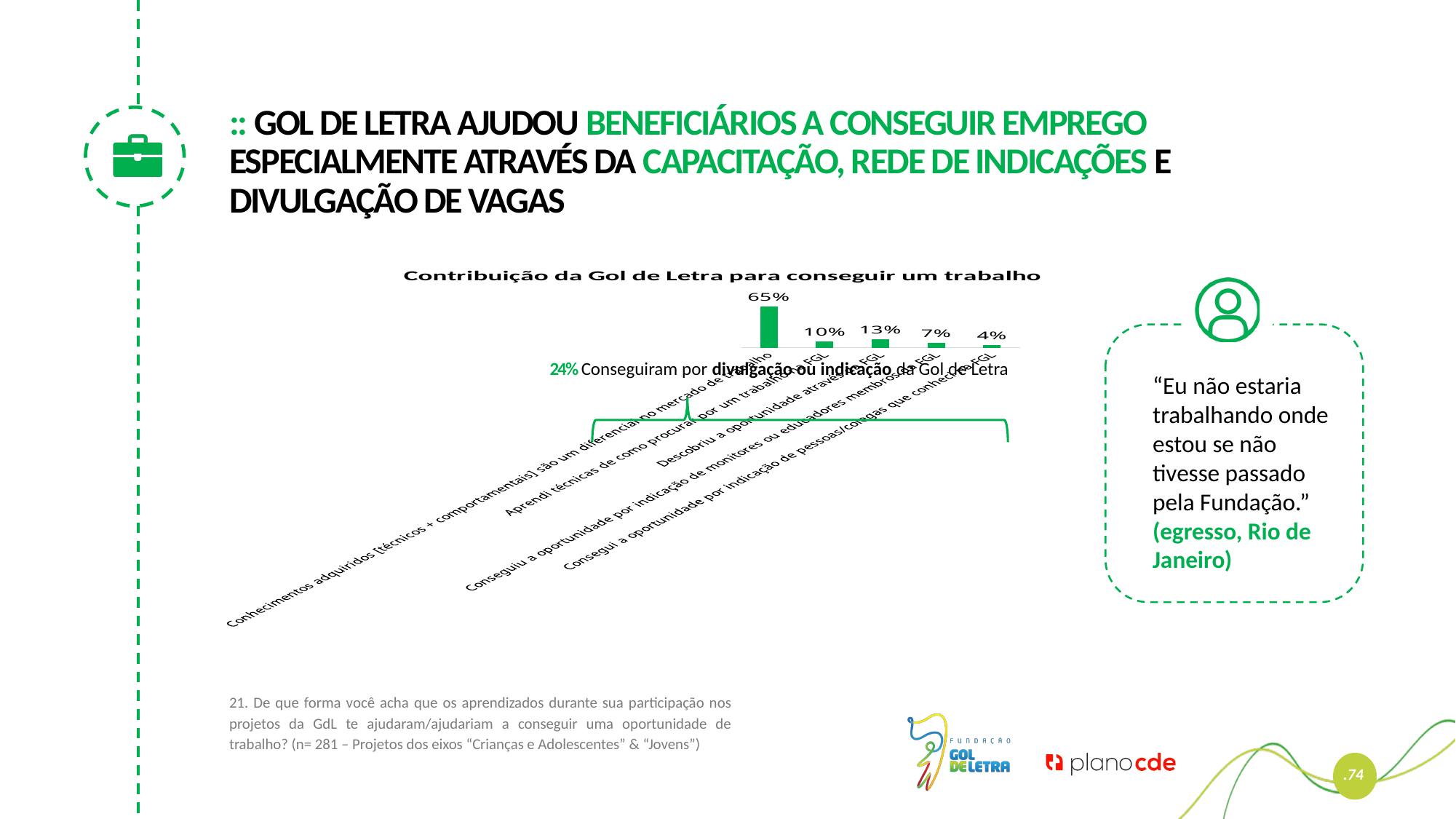
What is the value for 'Conseguiu a oportunidade por indicação de monitores ou educadores'? 7% Which is larger: the value for 'Aprendi técnicas de como procurar por um trabalho' or the value for 'Descobriu a oportunidade através da FGL'? Descobriu a oportunidade através da FGL Which category has the lowest value? Consegui a oportunidade por indicação de pessoas/colegas que conheci na FGL What is the value of the first bar, for 'Conhecimentos adquiridos [técnicos + comportamentais] são um diferencial no mercado de trabalho'? 65% What is the value for 'Aprendi técnicas de como procurar por um trabalho'? 10% What is the difference between the highest bar (65%) and the bar for 'Descobriu a oportunidade através da FGL' (13%)? 52 percentage points How many bars does the chart have? 5 What is the value for 'Descobriu a oportunidade através da FGL'? 13% What is the value of the last bar, for 'Consegui a oportunidade por indicação de pessoas/colegas'? 4% What is the title of the chart? Contribuição da Gol de Letra para conseguir um trabalho Which category has the highest value? Conhecimentos adquiridos [técnicos + comportamentais] são um diferencial no mercado de trabalho What type of chart is shown on the slide? bar chart